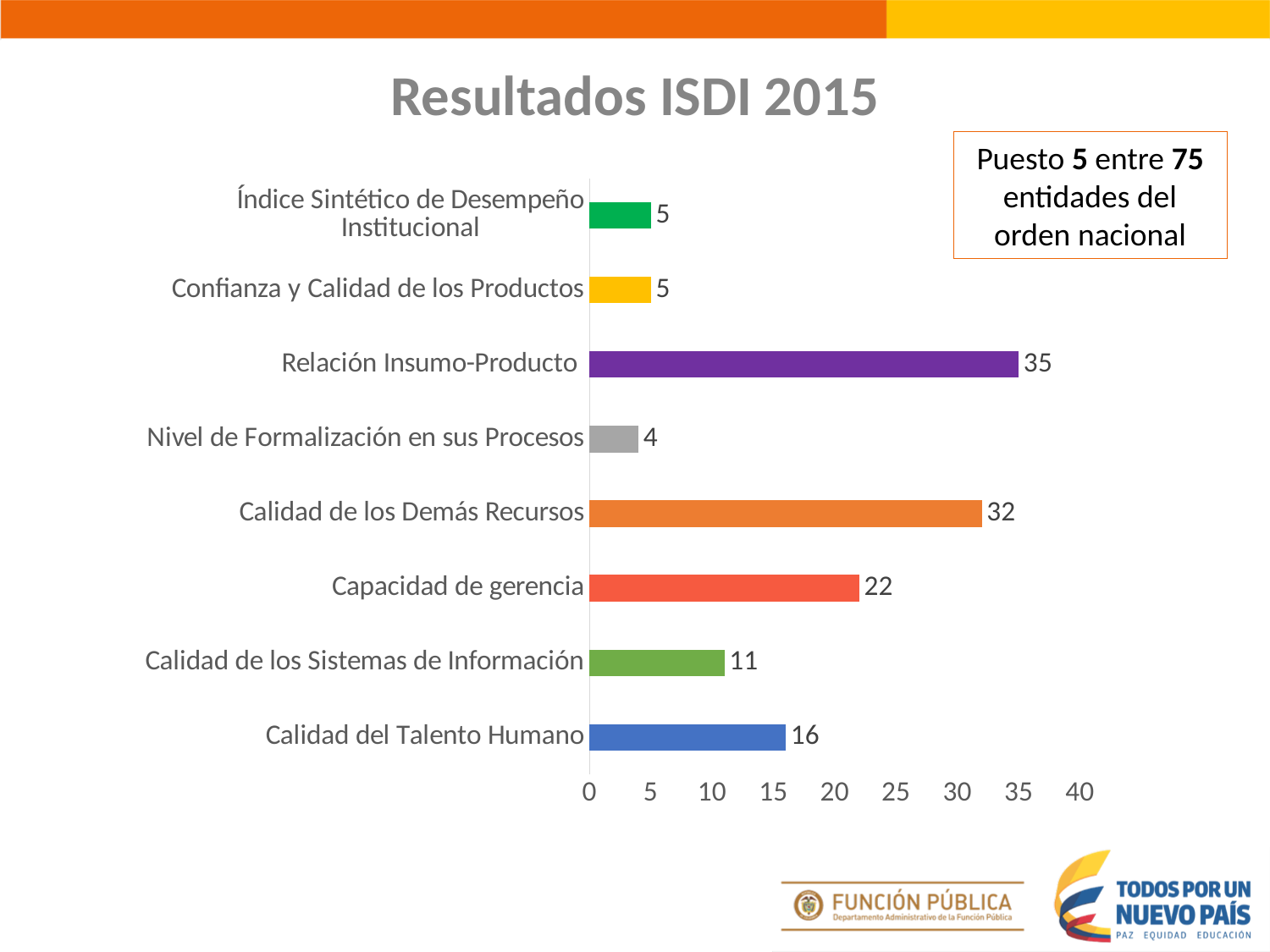
Which category has the highest value? Relación Insumo-Producto What is the value for Capacidad de gerencia? 22 What is the value for Nivel de Formalización en sus Procesos? 4 What is the value for Relación Insumo-Producto? 35 Which is larger, the value for Capacidad de gerencia or the value for Calidad de los Sistemas de Información? Capacidad de gerencia How many categories are shown in the chart? 8 What is the value for Calidad del Talento Humano? 16 Is the value for Calidad de los Demás Recursos greater or less than 30? greater What is the title of the slide containing the chart? Resultados ISDI 2015 What is the difference between the values for Relación Insumo-Producto and Calidad de los Demás Recursos? 3 Which category has the lowest value? Nivel de Formalización en sus Procesos What kind of chart is shown on the slide? Bar chart